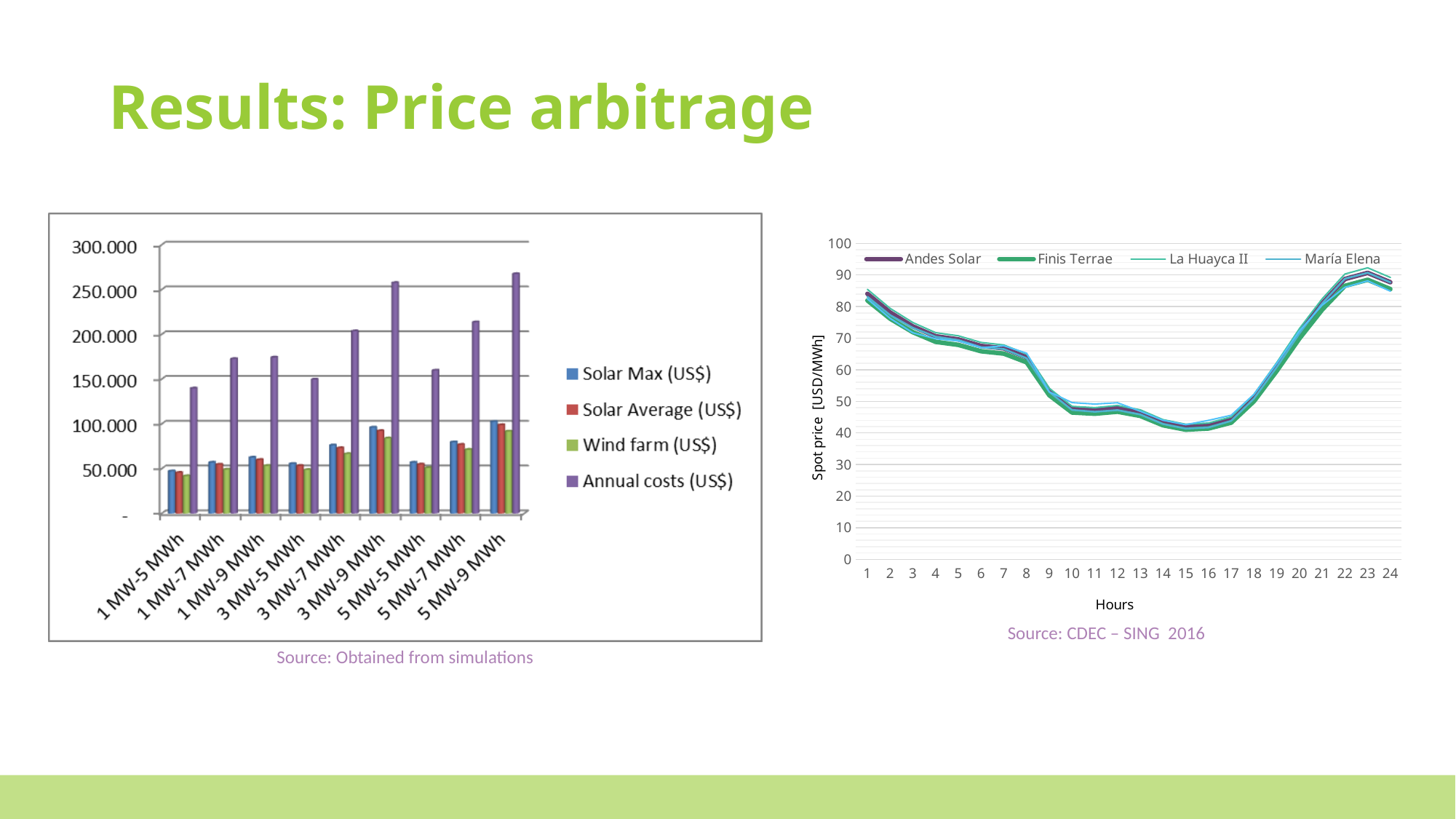
How many categories are shown on the x axis of the left bar chart? 9 In the right line chart, is the spot price for Andes Solar at hour 15 greater or less than 50? less How many series does the legend of the right line chart list? 4 What kind of chart is the chart on the left of the slide? bar chart In the right line chart, do the spot prices rise or fall from hour 1 to hour 8? fall In the left bar chart, is the Annual costs (US$) value for 1 MW-5 MWh greater or less than 150.000? less In the left bar chart, which is larger: Annual costs (US$) for 3 MW-9 MWh or for 1 MW-5 MWh? 3 MW-9 MWh How many series does the legend of the left bar chart list? 4 What kind of chart is the chart on the right of the slide? line chart How many hours are plotted on the x axis of the right line chart? 24 What is the y-axis label of the right line chart? Spot price [USD/MWh] In the left bar chart, is the Annual costs (US$) value for 5 MW-9 MWh greater or less than 250.000? greater